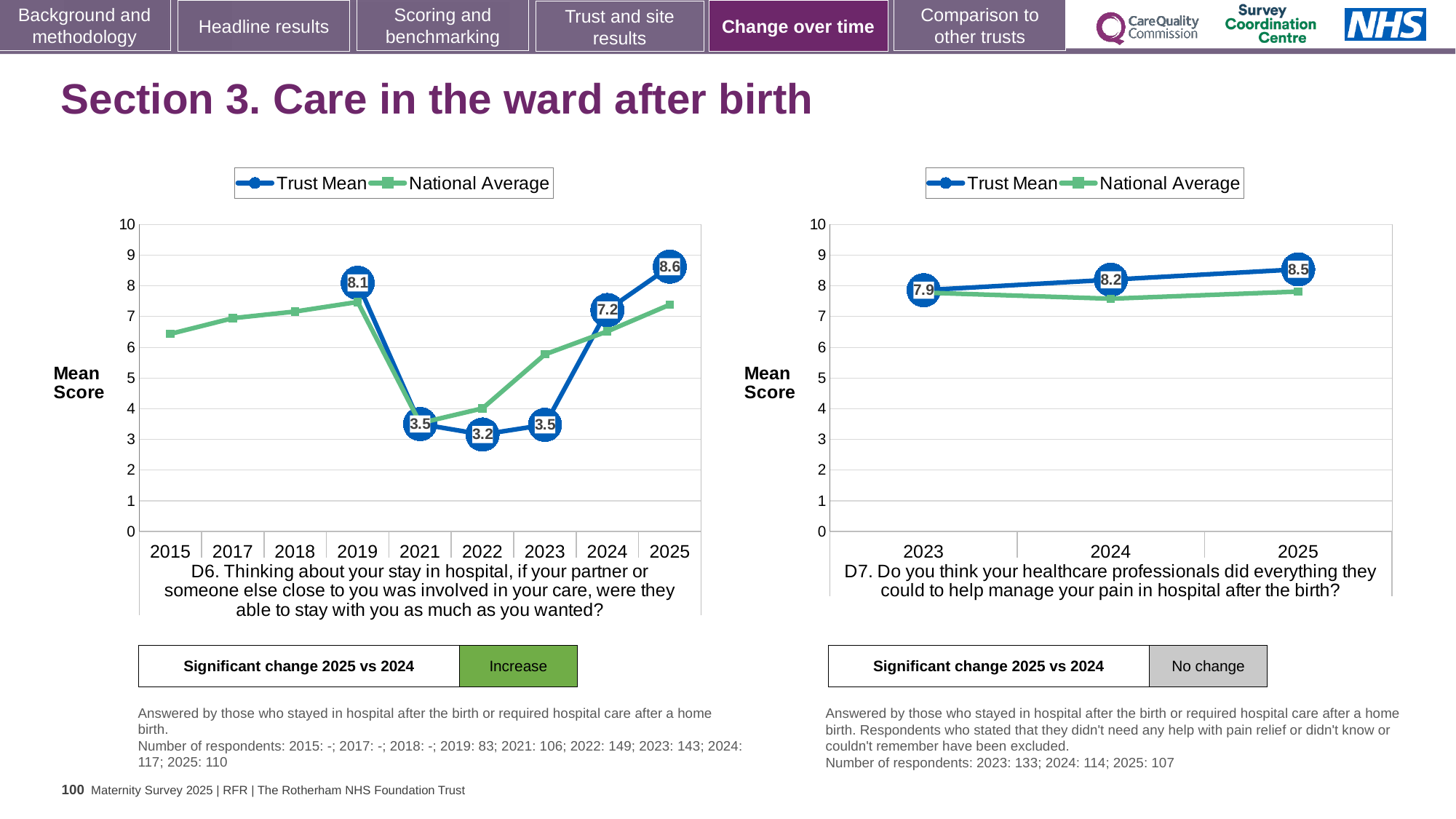
In the left chart (D6), which is larger: the Trust Mean for 2019 or the Trust Mean for 2024? 2019 In the right chart (D7), does the Trust Mean rise or fall from 2023 to 2025? rise In the left chart (D6), what is the difference between the Trust Mean for 2025 and the Trust Mean for 2024? 1.4 In the right chart (D7), what is the Trust Mean for 2024? 8.2 In the left chart (D6), what is the Trust Mean for 2025? 8.6 In the left chart (D6), what is the Trust Mean for 2022? 3.2 In the right chart (D7), which year has the highest Trust Mean? 2025 In the right chart (D7), what is the difference between the Trust Mean for 2025 and the Trust Mean for 2023? 0.6 In the left chart (D6), is the National Average for 2015 greater or less than 7? less In the left chart (D6), which year has the lowest labelled Trust Mean? 2022 How many years are shown on the x axis of the left chart (D6)? 9 How many series does the legend of the right chart (D7) list? 2